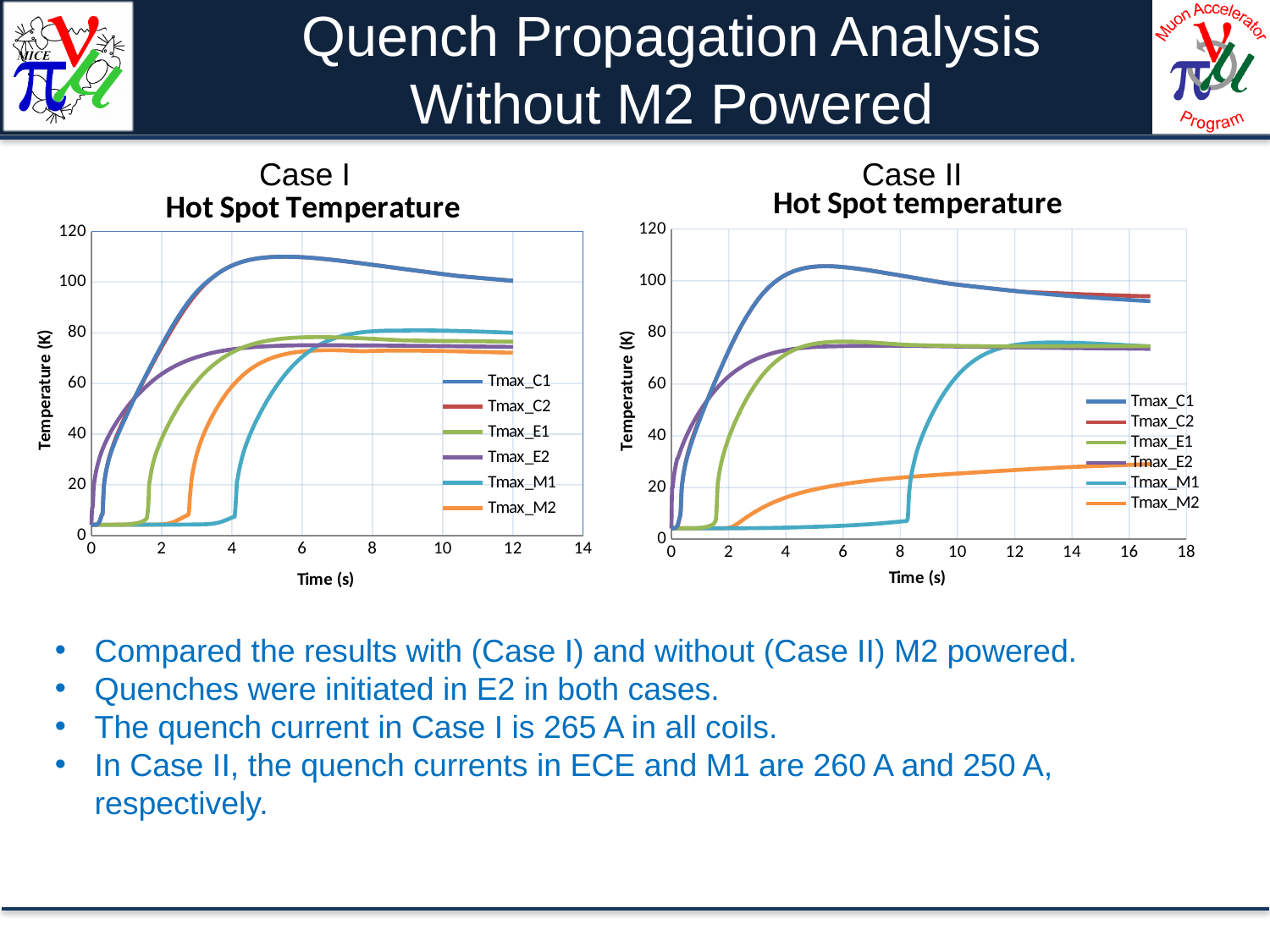
What is the y-axis label of the Case I Hot Spot Temperature chart? Temperature (K) How many series does the legend of the Case II Hot Spot temperature chart list? 6 In the Case II chart, is the value of Tmax_M1 at 6 s greater or less than 20? less In the Case II chart, is the value of Tmax_M2 at 16 s greater or less than 40? less What kind of chart is the Case I Hot Spot Temperature chart? line chart In the Case II chart, which series has the lowest temperature at the end of the time range? Tmax_M2 What is the highest x-axis tick shown on the Case II Hot Spot temperature chart? 18 In the Case II chart, is the peak value of Tmax_C1 greater or less than 100? greater In the Case I chart, does Tmax_C1 rise or fall between 6 s and 12 s? fall In the Case II chart, does Tmax_M2 rise or fall between 2 s and 16 s? rise